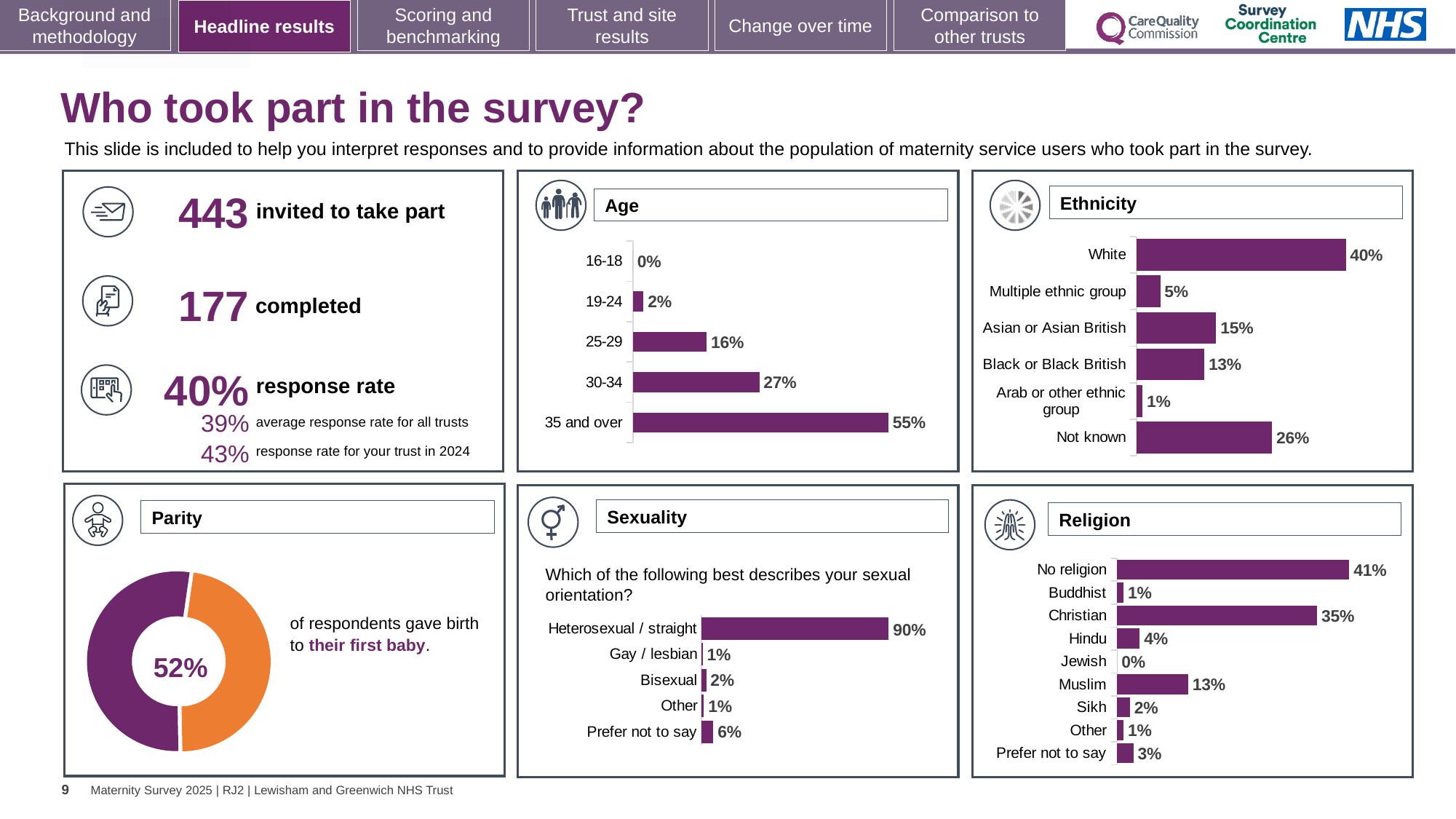
In the Age chart, what percentage of respondents were aged 35 and over? 55% In the Parity chart, what percentage of respondents gave birth to their first baby? 52% What kind of chart is the Religion chart? Bar chart In the Ethnicity chart, which category has the highest percentage? White In the Ethnicity chart, what percentage of respondents were White? 40% In the Ethnicity chart, which is larger: Asian or Asian British or Black or Black British? Asian or Asian British In the Age chart, which age group has the lowest percentage? 16-18 In the Sexuality chart, what percentage of respondents answered Heterosexual / straight? 90% In the Ethnicity chart, how many categories are shown? 6 In the Age chart, what is the difference between the 30-34 and 25-29 percentages? 11% In the Religion chart, what is the difference between No religion and Christian? 6% In the Sexuality chart, what percentage of respondents answered Prefer not to say? 6%